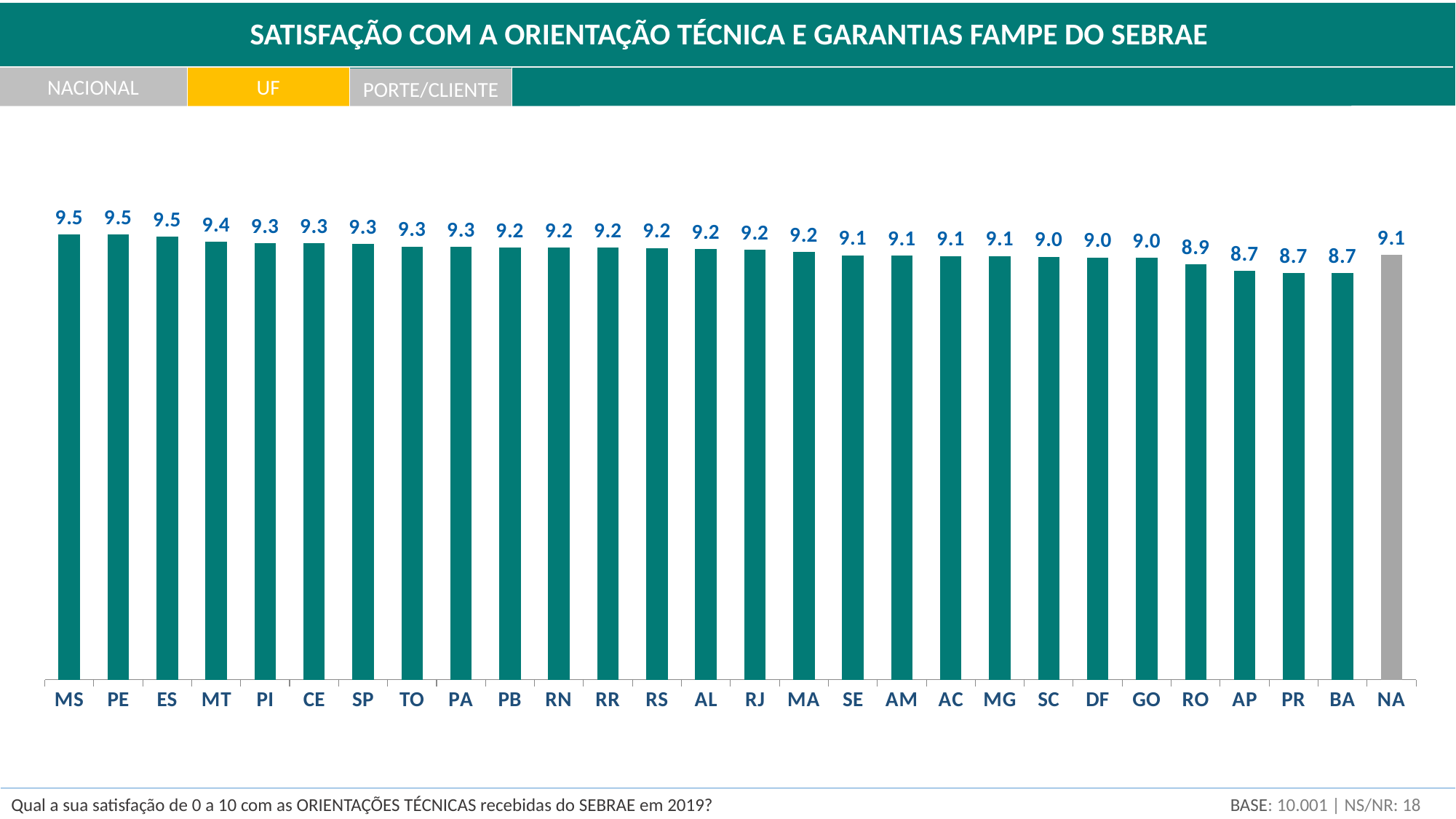
Which bar is coloured grey instead of green? NA What is the value for RO? 8.9 What is the value for MT? 9.4 What is the lowest value shown on the chart? 8.7 How many bars are shown on the chart? 28 What is the value for SC? 9.0 What is the highest value shown on the chart? 9.5 What is the value for the NA bar? 9.1 Do the values generally rise or fall from left to right across the chart? Fall What kind of chart is shown on the slide? Bar chart Which has a larger value, MT or RO? MT What is the difference between the values for MS and BA? 0.8